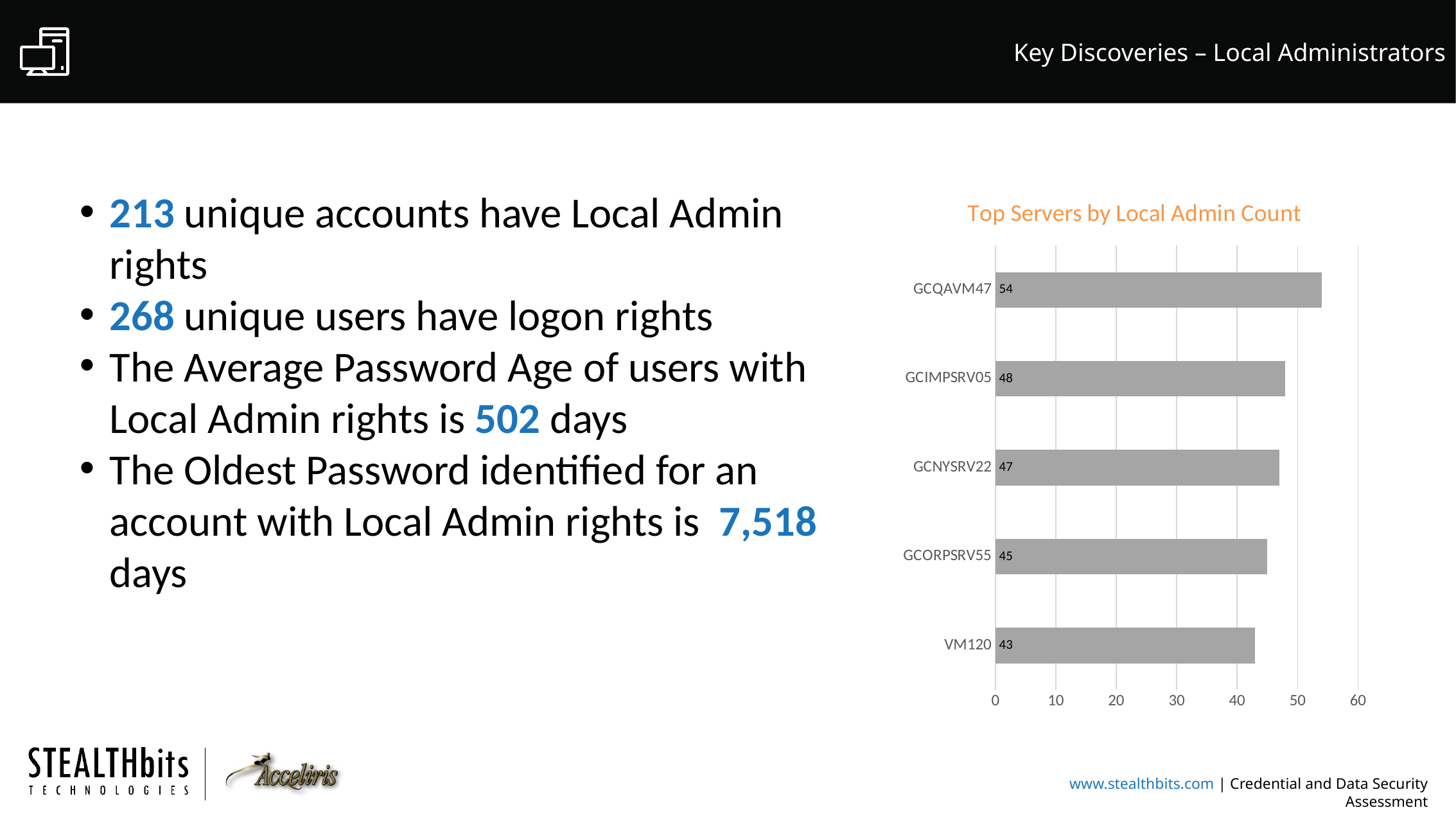
How many servers are shown in the chart? 5 What is the title of the chart? Top Servers by Local Admin Count What is the local admin count for GCQAVM47? 54 Which has a higher local admin count, GCIMPSRV05 or GCORPSRV55? GCIMPSRV05 Which server has the lowest local admin count? VM120 Which server has the highest local admin count? GCQAVM47 What is the local admin count for GCNYSRV22? 47 Is the value for GCQAVM47 greater or less than 50? greater What kind of chart is shown on the slide? bar chart What is the local admin count for VM120? 43 What is the difference between the local admin counts of GCQAVM47 and VM120? 11 What is the difference between the local admin counts of GCIMPSRV05 and GCORPSRV55? 3